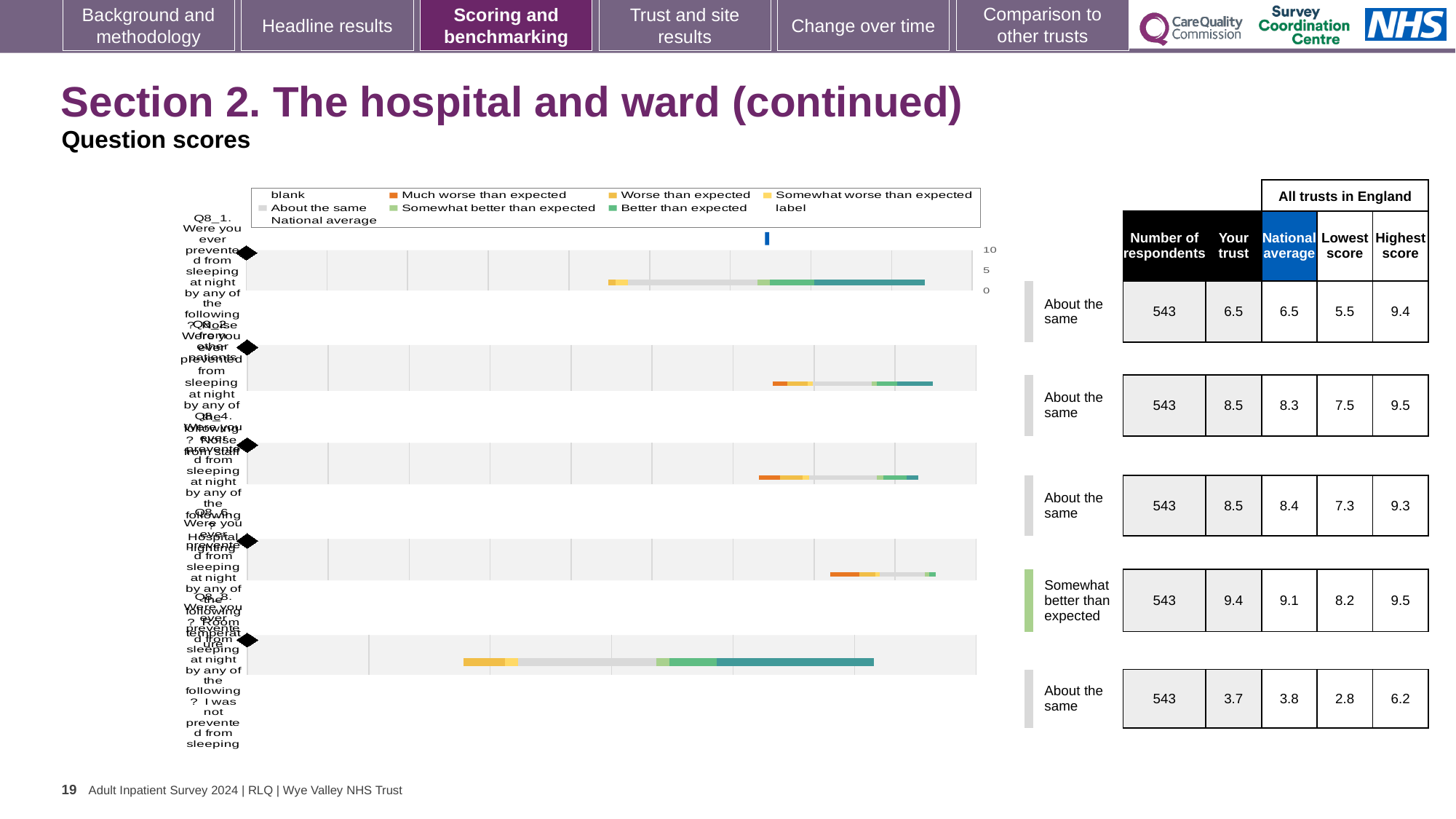
How many respondents answered Q8_6? 543 Which question is rated 'Somewhat better than expected' rather than 'About the same'? Q8_6 Which question has the highest 'Your trust' score? Q8_6 What is the difference between the 'Your trust' score and the national average for Q8_6? 0.3 What is the highest score among all trusts in England for Q8_4? 9.3 What is the 'Your trust' score for Q8_1? 6.5 What kind of chart is used to show the question scores on this slide? bar chart Which question has the lowest 'Your trust' score? Q8_8 What is the lowest score among all trusts in England for Q8_8? 2.8 For Q8_8, which is larger: the 'Your trust' score or the national average? National average What is the national average score for Q8_2? 8.3 How many questions (bars) are plotted in the chart? 5